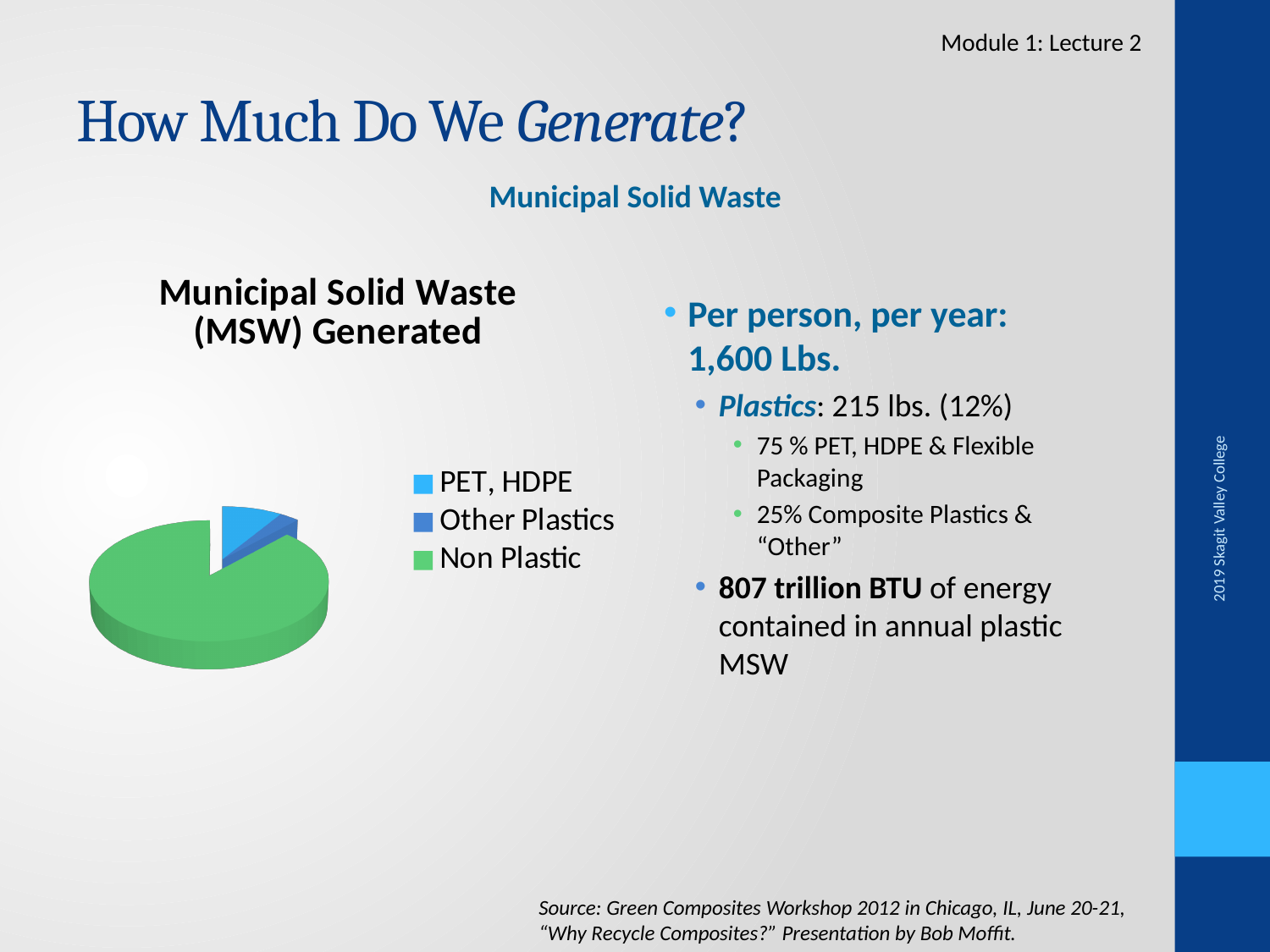
Which category takes up the smallest share of the pie chart? Other Plastics What kind of chart is shown on the slide? Pie chart Which legend entry is listed first in the pie chart's legend? PET, HDPE What is the title of the pie chart? Municipal Solid Waste (MSW) Generated How many slices does the pie chart have? 3 Which slice is larger in the pie chart, PET, HDPE or Other Plastics? PET, HDPE What colour is the Non Plastic slice in the pie chart? Green How many entries does the pie chart's legend list? 3 Which slice is larger in the pie chart, Non Plastic or PET, HDPE? Non Plastic Which category takes up the largest share of the pie chart? Non Plastic